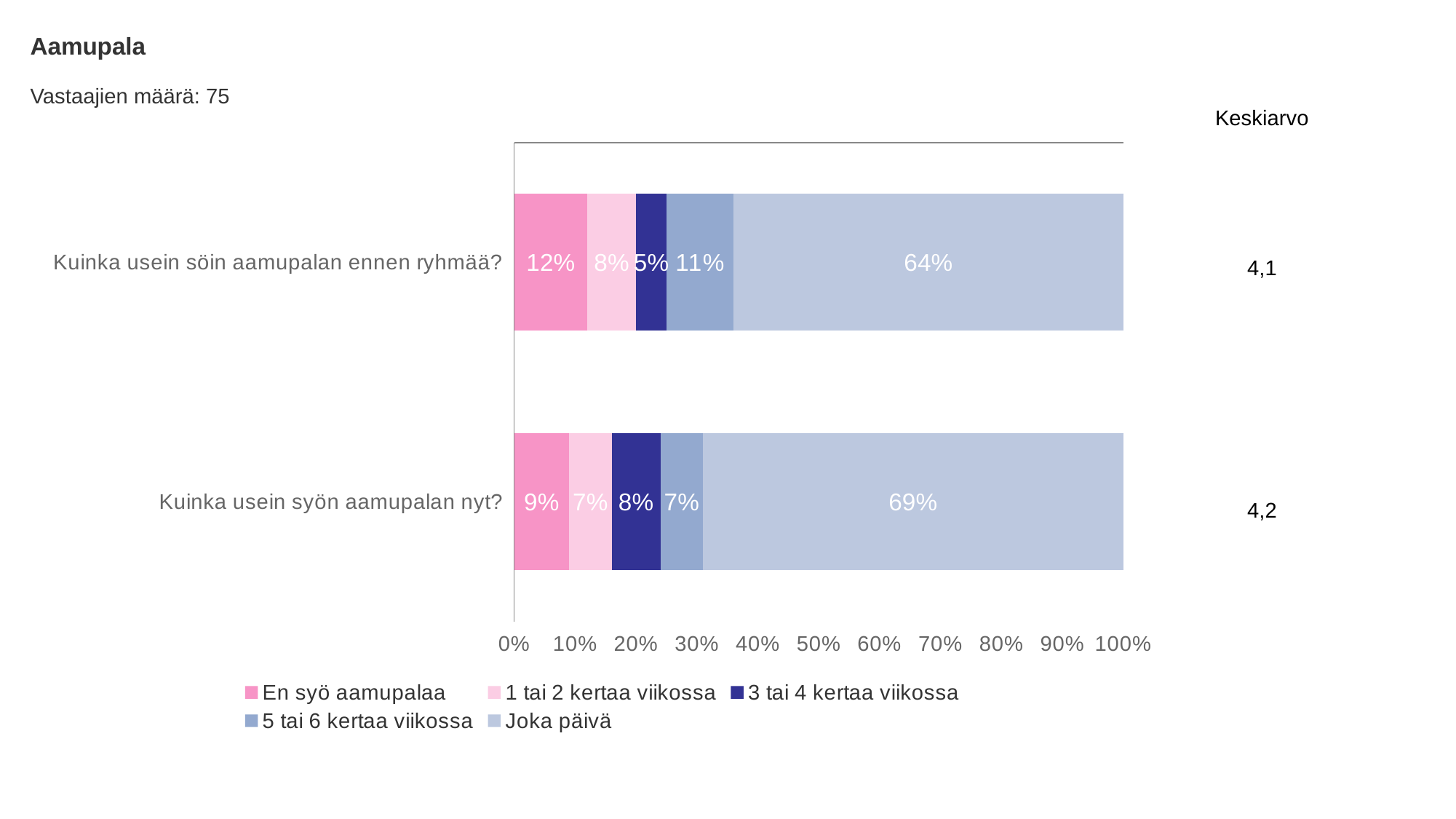
How many series does the legend list? 5 Which question has the larger "En syö aamupalaa" share: "Kuinka usein söin aamupalan ennen ryhmää?" or "Kuinka usein syön aamupalan nyt?"? Kuinka usein söin aamupalan ennen ryhmää? What is the difference between the "Joka päivä" shares for "Kuinka usein syön aamupalan nyt?" and "Kuinka usein söin aamupalan ennen ryhmää?"? 5% How many bars (questions) are plotted in the chart? 2 What kind of chart is shown on the slide? Stacked bar chart What is the value for "3 tai 4 kertaa viikossa" in the "Kuinka usein syön aamupalan nyt?" bar? 8% What percentage of respondents answered "Joka päivä" for "Kuinka usein syön aamupalan nyt?"? 69% Which series has the largest share in the "Kuinka usein söin aamupalan ennen ryhmää?" bar? Joka päivä What percentage of respondents answered "Joka päivä" for "Kuinka usein söin aamupalan ennen ryhmää?"? 64% What is the value for "En syö aamupalaa" in the "Kuinka usein söin aamupalan ennen ryhmää?" bar? 12% Which series has the smallest share in the "Kuinka usein söin aamupalan ennen ryhmää?" bar? 3 tai 4 kertaa viikossa What is the Keskiarvo (mean) shown for "Kuinka usein syön aamupalan nyt?"? 4,2